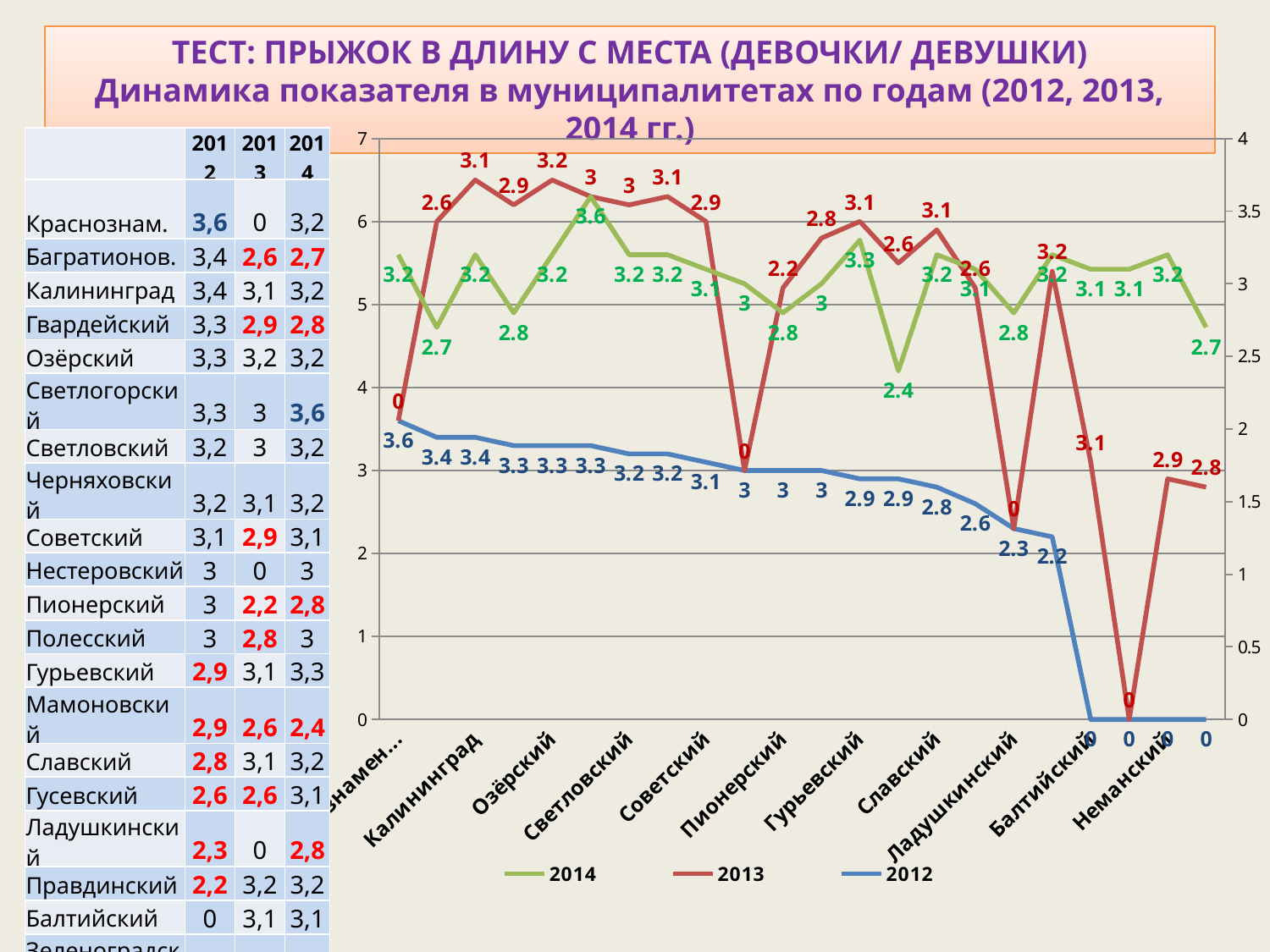
What is the 2013 value for Пионерский on the chart? 2.2 For Гурьевский, which series has the larger value, 2014 or 2013? 2014 What colour is the line for the 2013 series? red For Балтийский, what is the difference between the 2013 value and the 2012 value? 3.1 What is the 2012 value for Калининград on the chart? 3.4 What is the 2014 value for Ладушкинский on the chart? 2.8 What is the 2012 value for Балтийский on the chart? 0 How many series does the chart legend list? 3 What is the 2013 value for Славский on the chart? 3.1 What kind of chart is shown on the slide? line chart Does the 2012 series generally rise or fall from left to right along the x axis? fall For Ладушкинский, which series has the larger value, 2012 or 2013? 2012